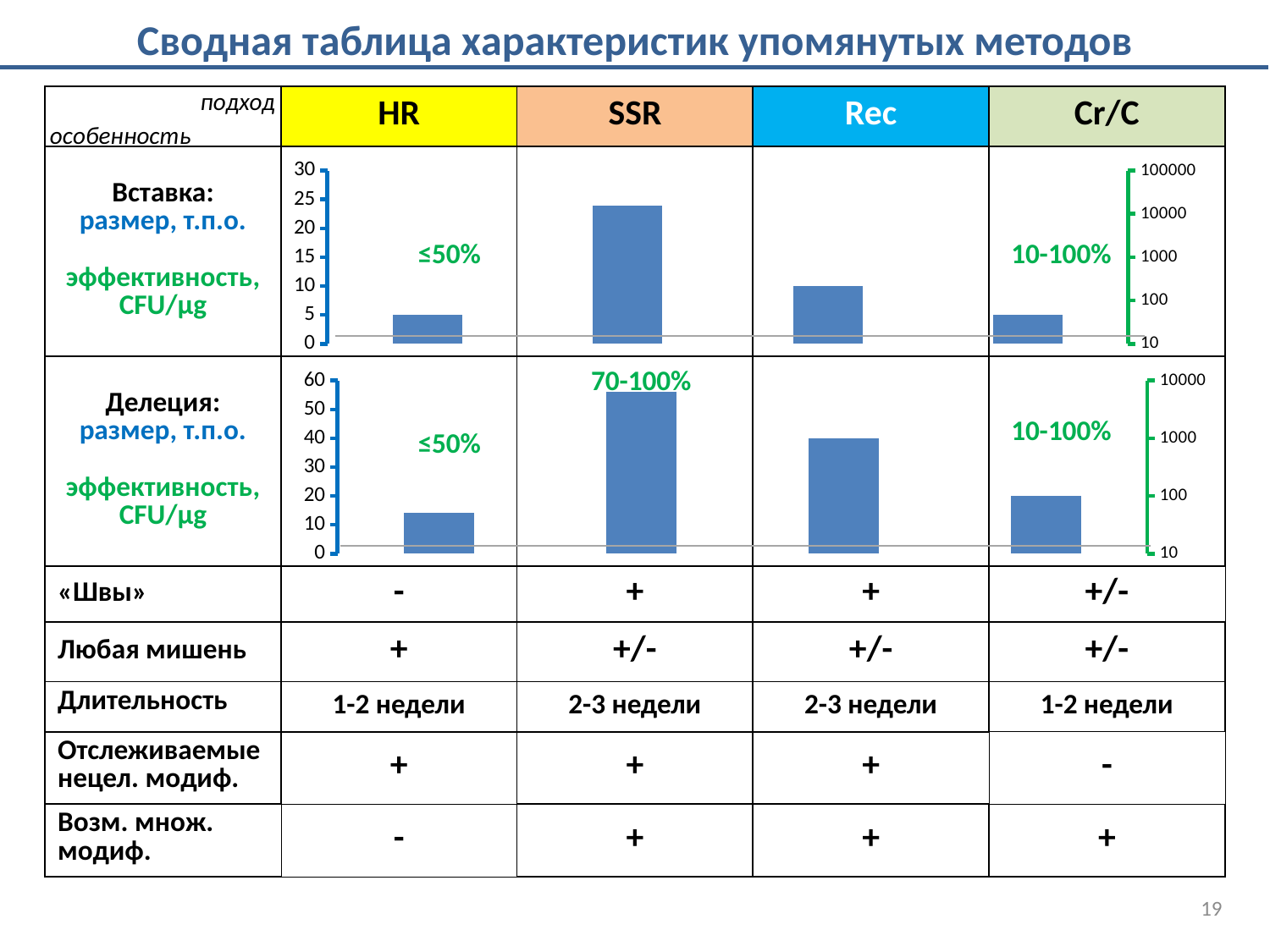
In the Вставка row chart, is the value for Rec greater or less than 15 on the left axis? less What kind of chart is shown in the Вставка row of the table? bar chart In the Вставка row chart, which approach has the highest bar? SSR In the Вставка row chart, is the value for HR greater or less than 10 on the left axis? less In the Делеция row chart, is the value for Rec greater or less than 30 on the left axis? greater In the Делеция row chart, which approach has the highest bar? SSR In the Делеция row chart, which approach has the lowest bar? HR In the Делеция row chart, what percentage label is printed above the SSR bar? 70-100% In the Вставка row chart, how many bars are plotted? 4 In the Вставка row chart, which is larger, the bar for SSR or the bar for Rec? SSR